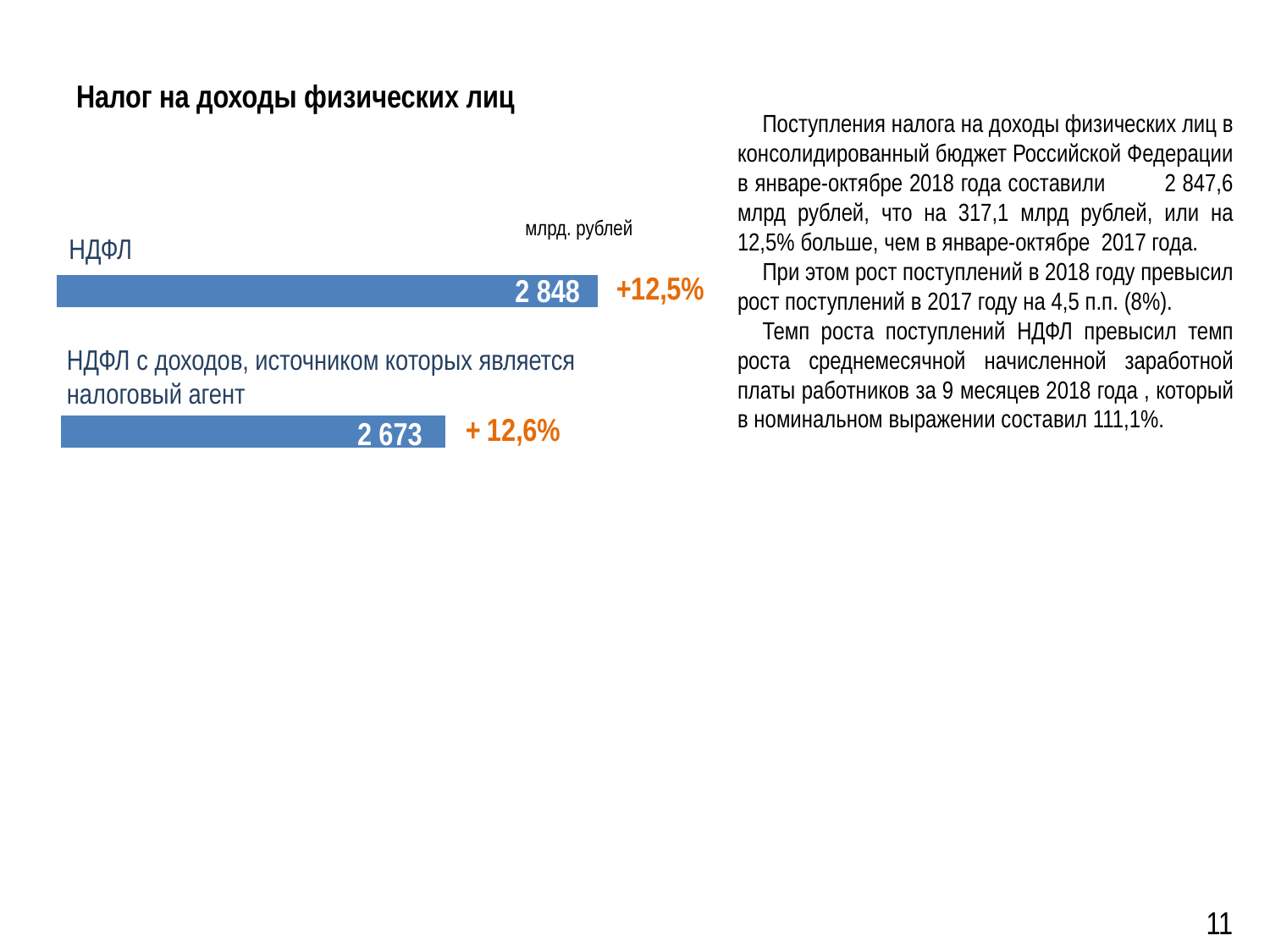
How many bars are shown on the chart? 2 What type of chart is shown on the slide? bar chart Which bar has the higher value, НДФЛ or НДФЛ с доходов, источником которых является налоговый агент? НДФЛ What growth percentage is shown next to the bar for НДФЛ с доходов, источником которых является налоговый агент? + 12,6% In what units are the chart values expressed? млрд. рублей What is the title of the slide containing the chart? Налог на доходы физических лиц Which bar has the lowest value on the chart? НДФЛ с доходов, источником которых является налоговый агент What is the difference between the НДФЛ value and the value for НДФЛ с доходов, источником которых является налоговый агент? 175 What growth percentage is shown next to the НДФЛ bar? +12,5% What is the value shown for НДФЛ on the bar chart? 2 848 What is the value shown for НДФЛ с доходов, источником которых является налоговый агент? 2 673